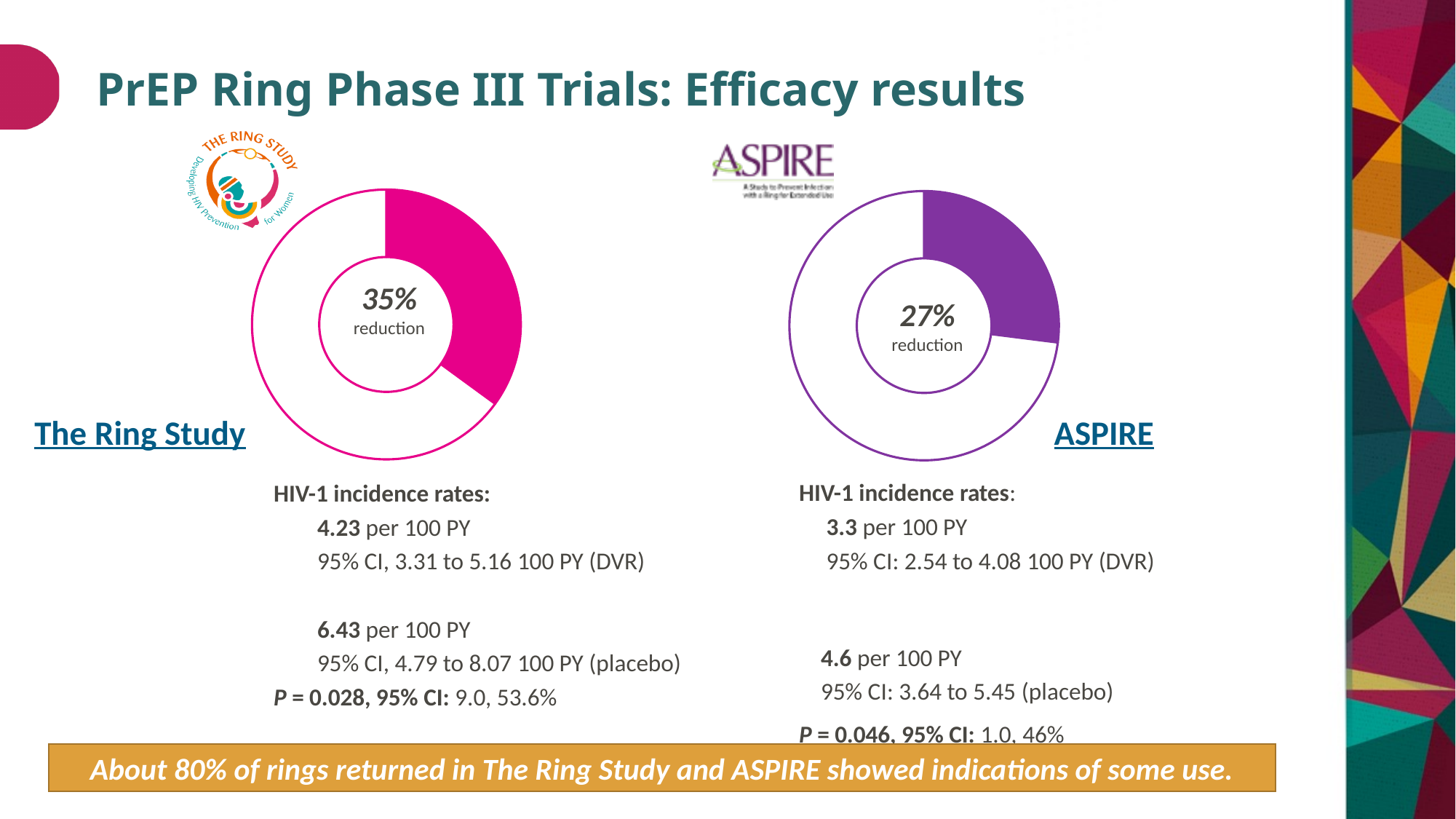
Which study's chart shows the larger reduction, The Ring Study or ASPIRE? The Ring Study What colour is the filled segment of the ASPIRE donut chart? Purple What share of The Ring Study donut chart is filled in pink? 35% What is the difference in percentage points between the reduction shown for The Ring Study and the reduction shown for ASPIRE? 8 percentage points What kind of chart is used to show the reduction for The Ring Study? Donut (pie) chart Is the reduction shown in the ASPIRE chart greater or less than 25%? greater What share of the ASPIRE donut chart is filled in purple? 27% What percentage reduction is shown in the centre of The Ring Study donut chart? 35% What percentage reduction is shown in the centre of the ASPIRE donut chart? 27% How many donut charts are shown on the slide? 2 Is the reduction shown in The Ring Study chart greater or less than 50%? less What colour is the filled segment of The Ring Study donut chart? Pink